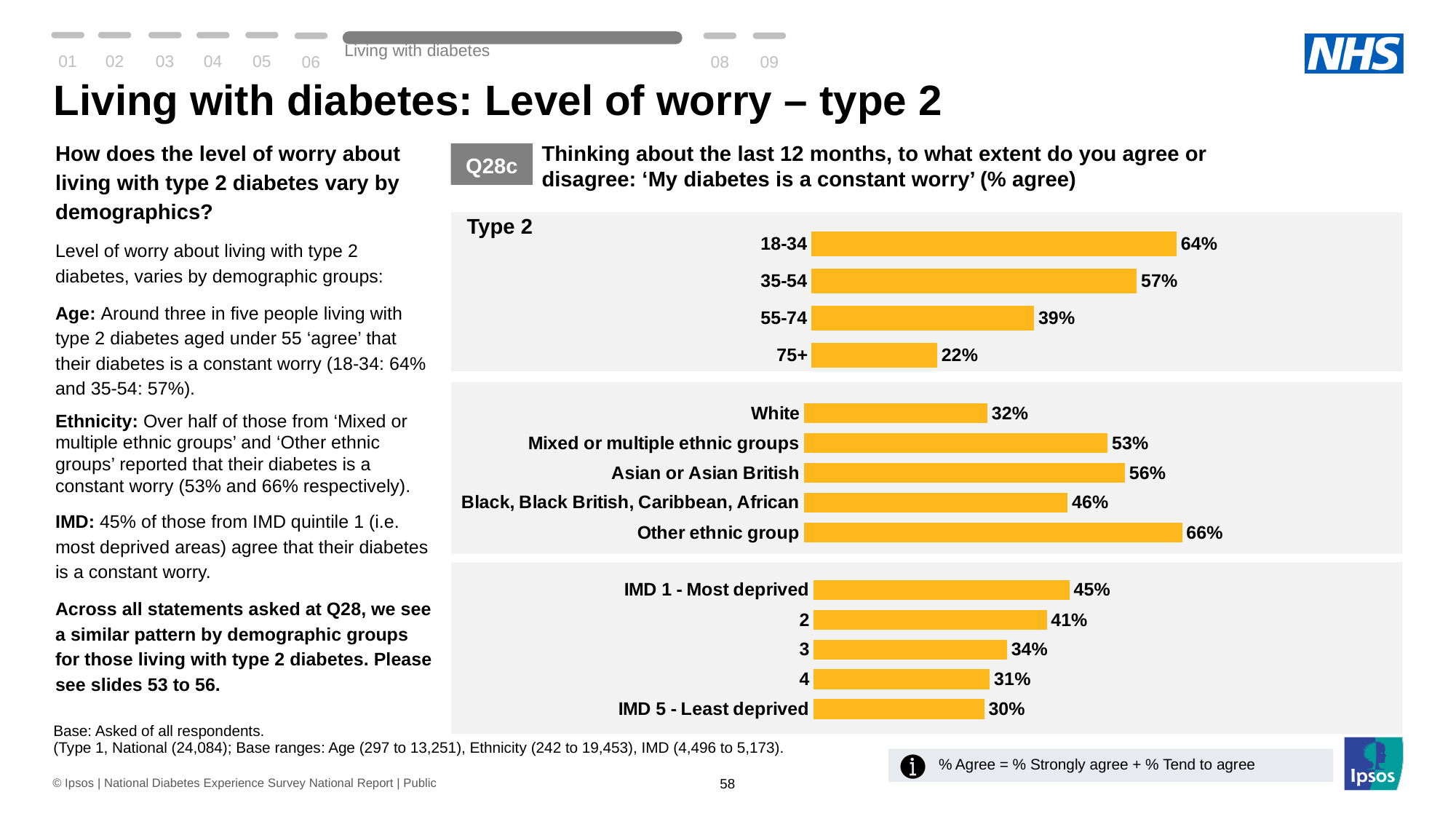
In the IMD chart (bottom panel), do the values rise or fall from IMD 1 - Most deprived to IMD 5 - Least deprived? Fall How many categories are shown in the IMD chart (bottom panel)? 5 In the age chart (top panel), what is the difference in percentage points between the 18-34 and 75+ groups? 42 percentage points In the age chart (top panel), what is the value for the 75+ age group? 22% In the ethnicity chart (middle panel), which group has the highest percentage agreeing? Other ethnic group In the age chart (top panel), what percentage of people aged 18-34 agree that their diabetes is a constant worry? 64% What colour are the bars in the charts? Yellow/orange In the ethnicity chart (middle panel), which group has the lowest percentage agreeing? White In the IMD chart (bottom panel), what is the value for IMD 5 - Least deprived? 30% What type of chart is used on this slide? Bar chart In the ethnicity chart (middle panel), what is the difference between Other ethnic group and Mixed or multiple ethnic groups? 13 percentage points In the ethnicity chart (middle panel), which is larger: the value for Asian or Asian British or the value for Black, Black British, Caribbean, African? Asian or Asian British